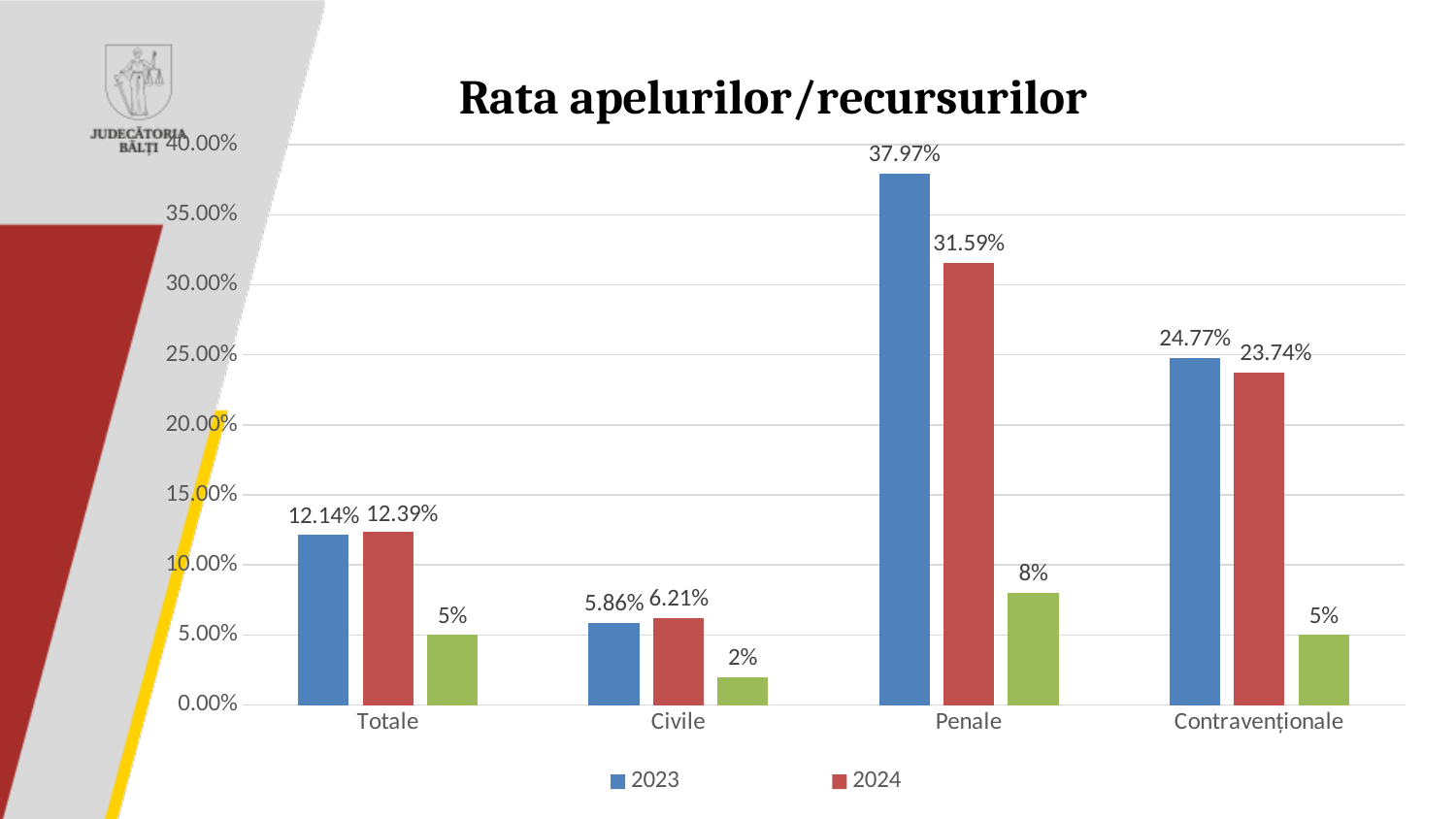
What kind of chart is shown on the slide? Bar chart What is the title of the chart? Rata apelurilor/recursurilor What is the value for 2023 in the Civile category? 5.86% In the Contravenționale category, which is larger: the 2023 value or the 2024 value? 2023 What is the value for 2024 in the Totale category? 12.39% Which category has the highest value for 2023? Penale What is the value for 2023 in the Penale category? 37.97% How many categories are shown on the x axis? 4 Which category has the lowest value for 2024? Civile What is the difference between the 2023 and 2024 values in the Penale category? 6.38% How many series does the legend list? 2 What is the value for 2024 in the Contravenționale category? 23.74%